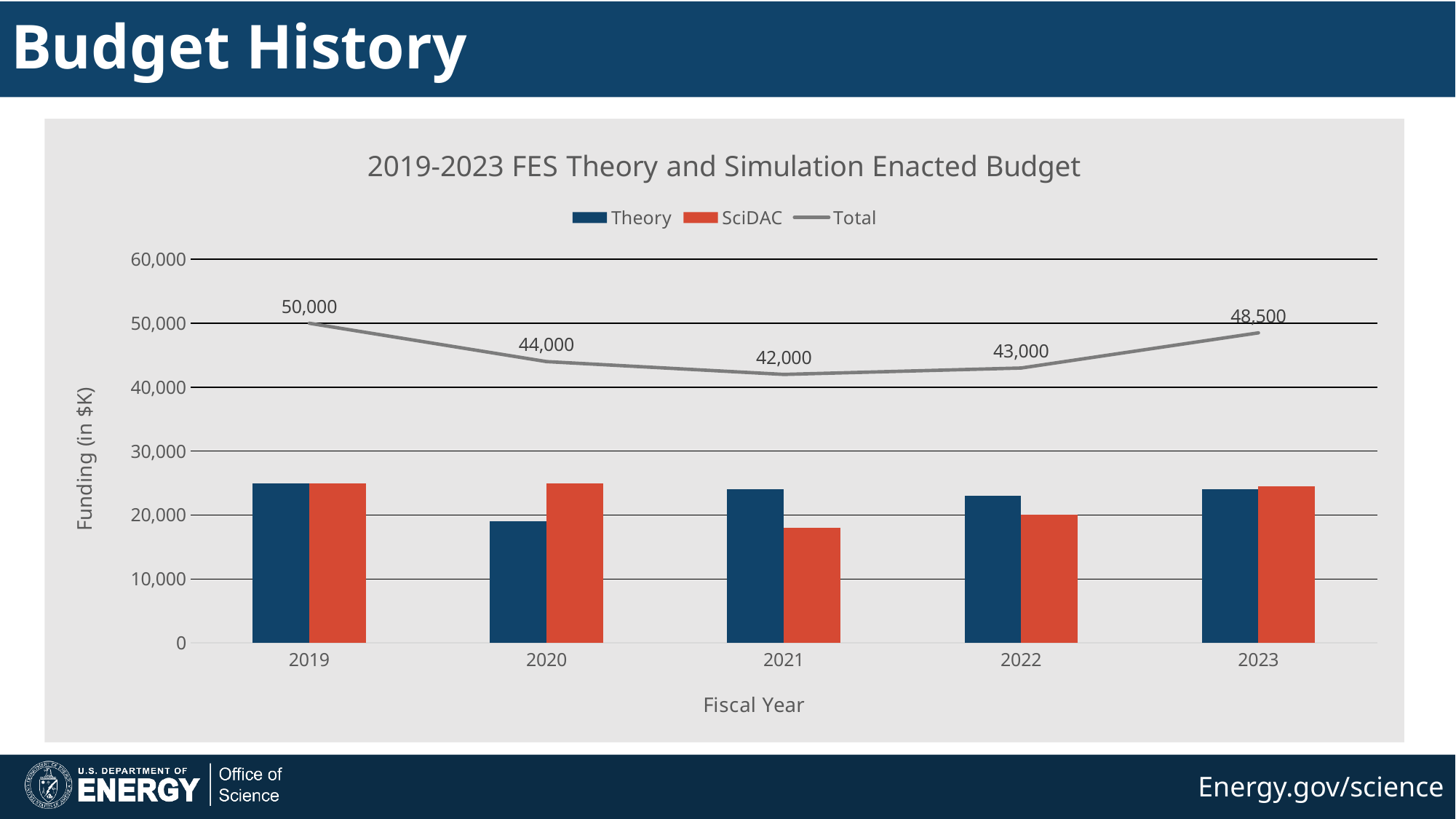
What is the difference between the Total for 2019 and the Total for 2020? 6,000 In which fiscal year is the Total lowest? 2021 Is the value for Theory in 2020 greater or less than 20,000? less How many fiscal years are shown on the x axis? 5 In which fiscal year is the Total highest? 2019 In fiscal year 2020, which is larger, the Theory bar or the SciDAC bar? SciDAC How many series does the legend list? 3 What is the Total value for fiscal year 2021? 42,000 What is the Total value for fiscal year 2023? 48,500 In fiscal year 2021, which is larger, the Theory bar or the SciDAC bar? Theory What is the difference between the Total for 2023 and the Total for 2022? 5,500 What is the Total value for fiscal year 2019? 50,000